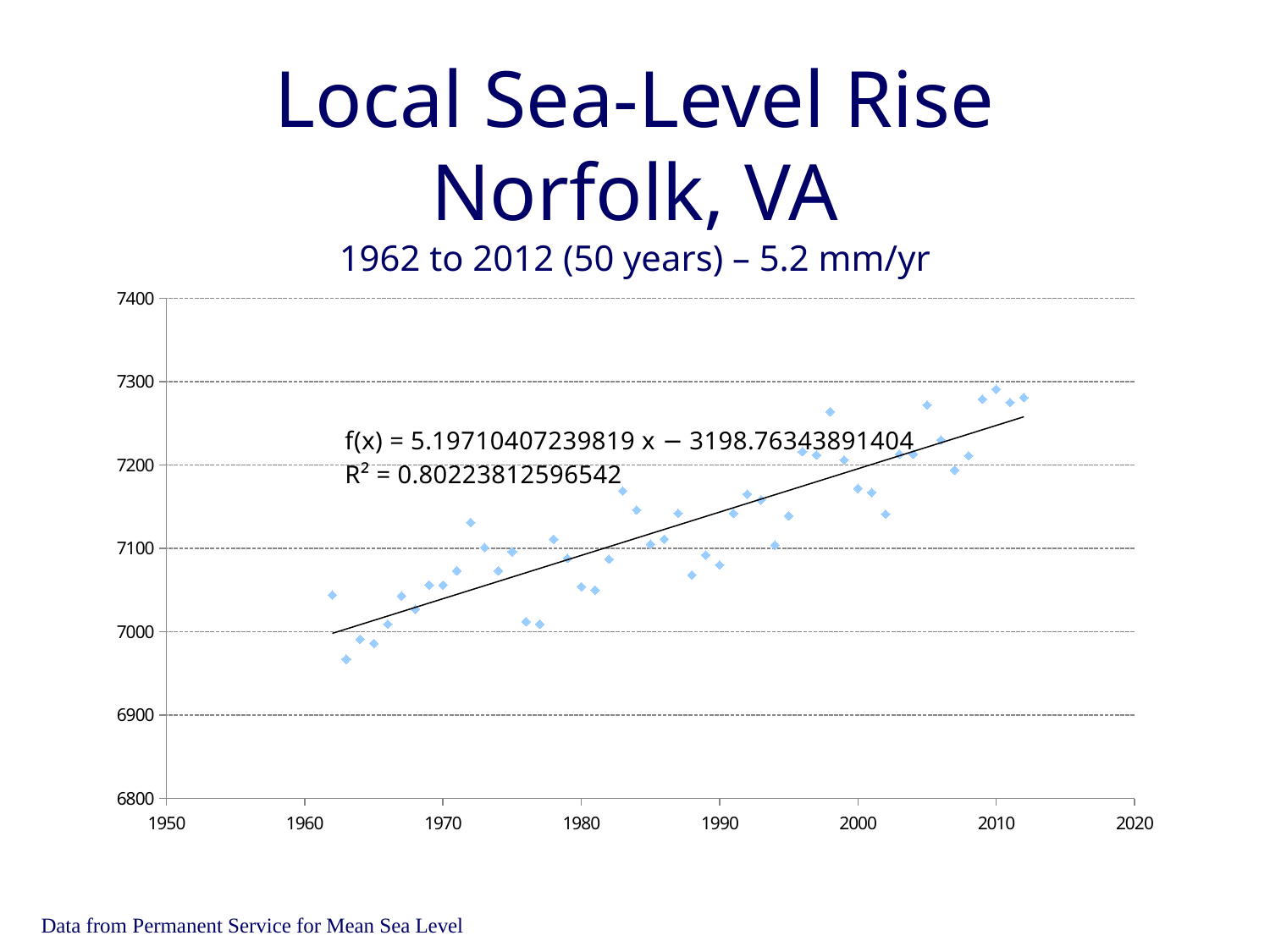
Do the plotted sea-level values generally rise or fall from 1962 to 2012? rise Is the value plotted for 1980 greater or less than 7100? less Is the value plotted for 1972 greater or less than 7100? greater Which year has the highest plotted value? 2010 Which year has the larger plotted value, 1998 or 1980? 1998 Is the value plotted for 1998 greater or less than 7200? greater What kind of chart is shown on the slide? scatter chart What rate of sea-level rise is given in the slide subtitle? 5.2 mm/yr What R² value is printed on the chart? 0.80223812596542 Which year has the lowest plotted value? 1963